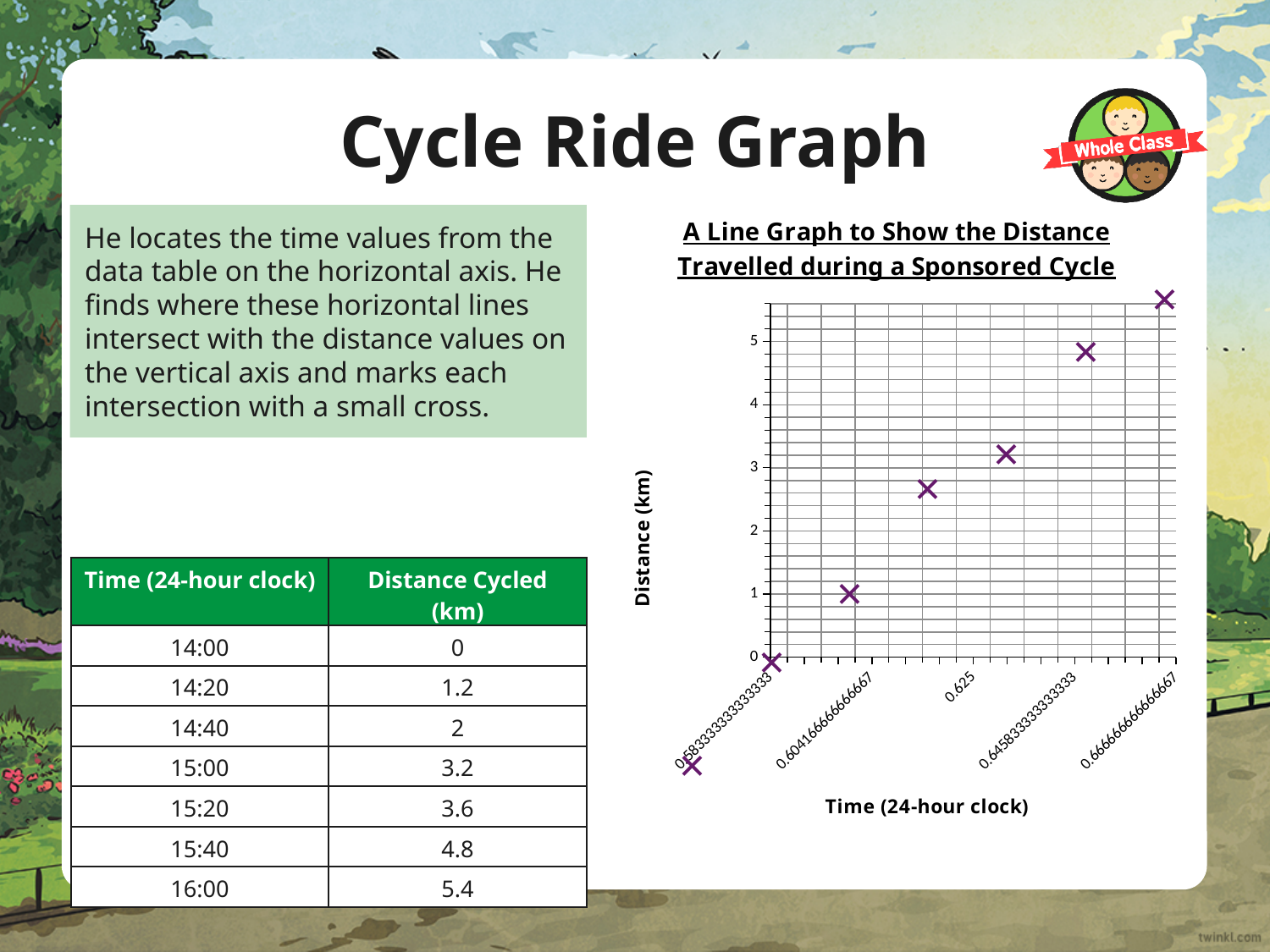
Is the value of the third plotted point from the left greater or less than 3? less Is the value of the highest plotted point on the chart greater or less than 5? greater What is the highest numbered tick label shown on the vertical axis of the chart? 5 Is the value of the second-highest plotted point (the one just below the top-right point) greater or less than 4? greater What is the title of the chart on the slide? A Line Graph to Show the Distance Travelled during a Sponsored Cycle What is the label on the vertical axis of the chart? Distance (km) Do the plotted distance values rise or fall as you move from left to right along the horizontal axis? rise Which plotted point has the highest distance value: the leftmost point or the rightmost point? the rightmost point